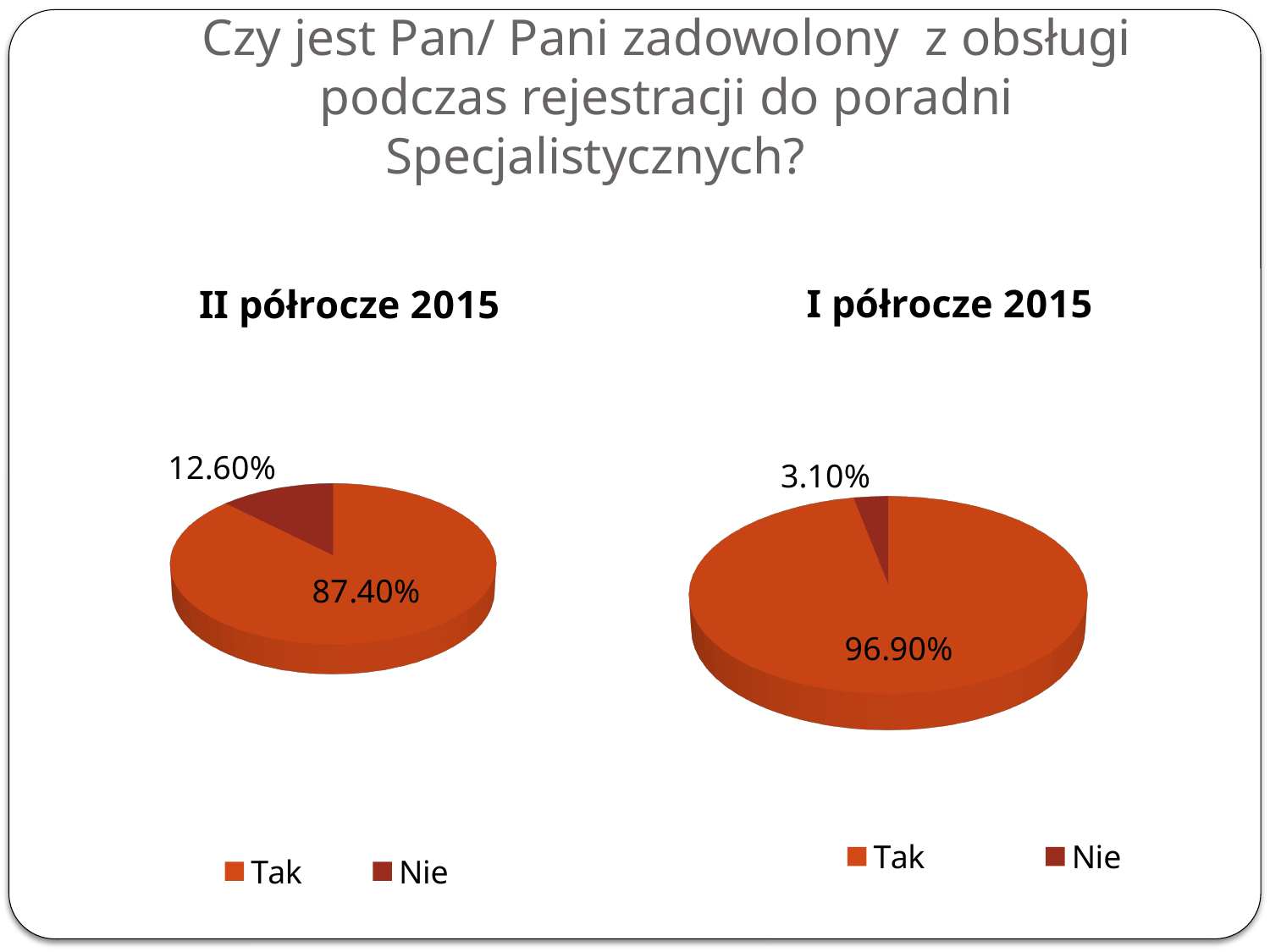
Is the Nie value larger in the "I półrocze 2015" chart or the "II półrocze 2015" chart? II półrocze 2015 What kind of chart is the "I półrocze 2015" chart? pie chart In the "II półrocze 2015" chart, what is the difference between the Tak and Nie values? 74.80% What is the difference between the Tak values in the "I półrocze 2015" and "II półrocze 2015" charts? 9.50% In the "I półrocze 2015" chart, what is the value for Tak? 96.90% How many entries does the legend of the "I półrocze 2015" chart list? 2 In the "II półrocze 2015" chart, what is the value for Tak? 87.40% How many slices does the "II półrocze 2015" chart have? 2 In the "II półrocze 2015" chart, what is the value for Nie? 12.60% In the "I półrocze 2015" chart, which category has the largest slice? Tak In the "II półrocze 2015" chart, which category has the smallest slice? Nie In the "I półrocze 2015" chart, what is the value for Nie? 3.10%